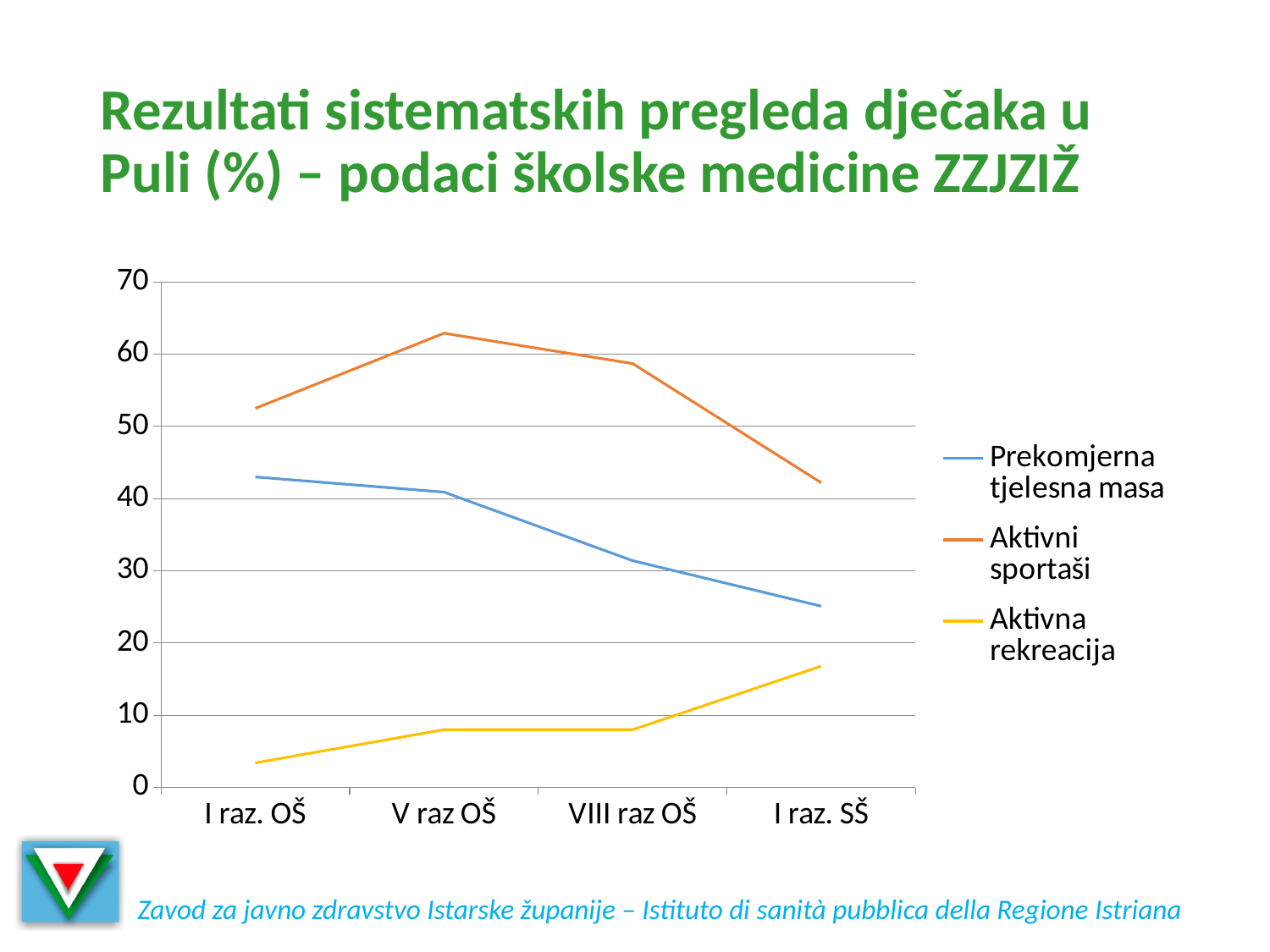
How many series does the legend list? 3 What kind of chart is shown on the slide? line chart Does the Aktivna rekreacija series rise or fall from I raz. OŠ to I raz. SŠ? rise Is the value for Aktivna rekreacija at I raz. SŠ greater or less than 10? greater Does the Prekomjerna tjelesna masa series rise or fall from I raz. OŠ to I raz. SŠ? fall Is the value for Aktivni sportaši at I raz. SŠ greater or less than 50? less At I raz. SŠ, which series has the larger value: Aktivni sportaši or Prekomjerna tjelesna masa? Aktivni sportaši Is the value for Aktivni sportaši at V raz OŠ greater or less than 60? greater How many categories are shown on the x axis? 4 At which category does the Aktivni sportaši series reach its highest value? V raz OŠ At which category is the Prekomjerna tjelesna masa series lowest? I raz. SŠ